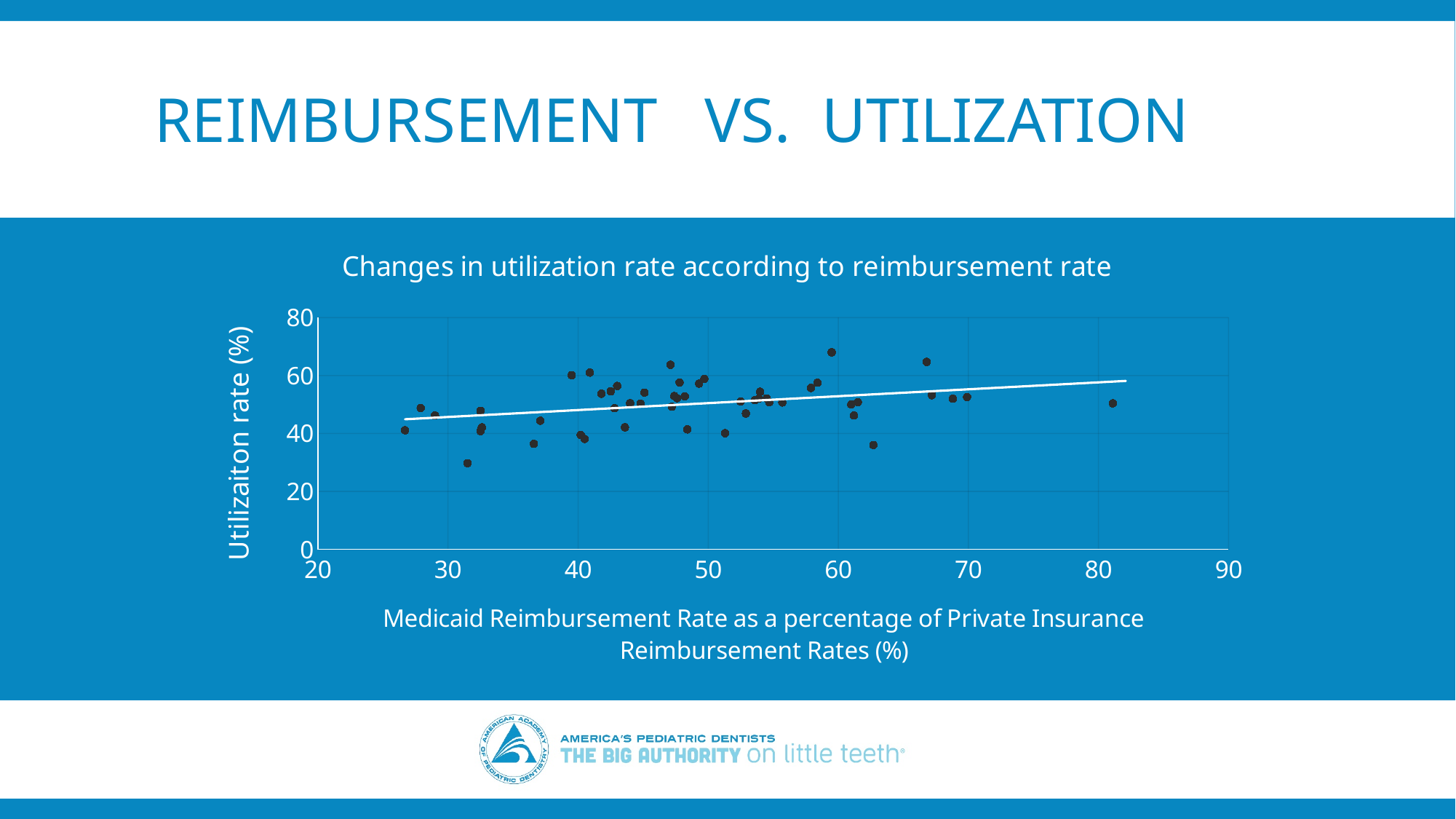
Is the utilization rate of the leftmost point (near 27 on the x axis) greater or less than 60? less Is the utilization rate of the point near 63 on the x axis (the lowest point on the right half) greater or less than 40? less What kind of chart is shown on the slide? Scatter chart Is the utilization rate of the rightmost point (near 81 on the x axis) greater or less than 40? greater What is the title of the chart? Changes in utilization rate according to reimbursement rate As the Medicaid reimbursement rate increases along the x axis, does the trend line rise or fall? Rises What is the label of the x axis? Medicaid Reimbursement Rate as a percentage of Private Insurance Reimbursement Rates (%)